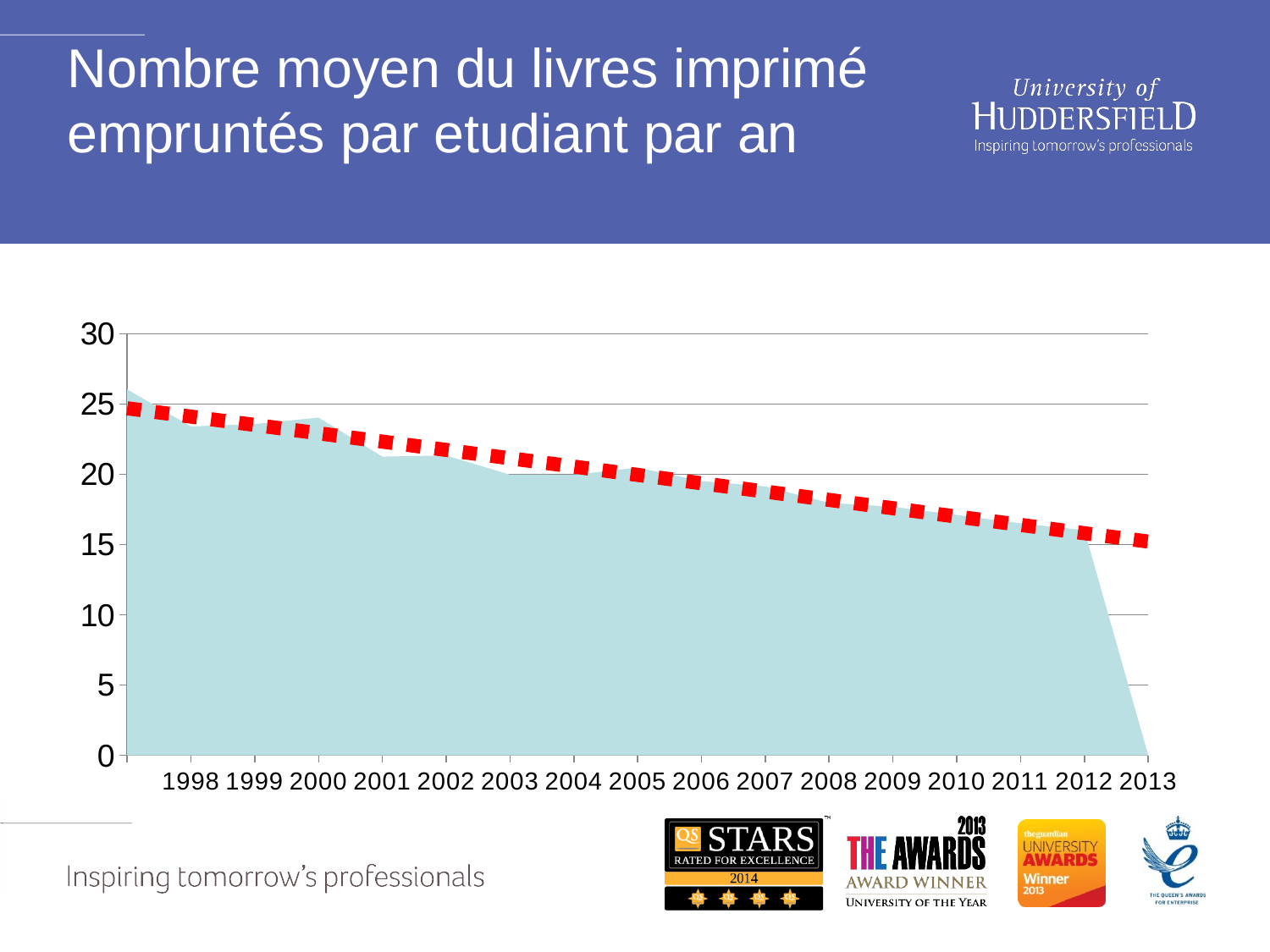
What is the first year labelled on the x axis? 1998 How many years are labelled on the x axis of the chart? 16 What kind of chart is shown on the slide? area chart Which year has the highest value in the chart? 2000 Is the value for 1998 greater or less than 20? greater Which year has the larger value, 2000 or 2010? 2000 Which year has the larger value, 1998 or 2012? 1998 Do the values generally rise or fall from 1998 to 2012? fall Is the value for 2012 greater or less than 20? less Is the value for 2008 greater or less than 20? less What is the last year labelled on the x axis? 2013